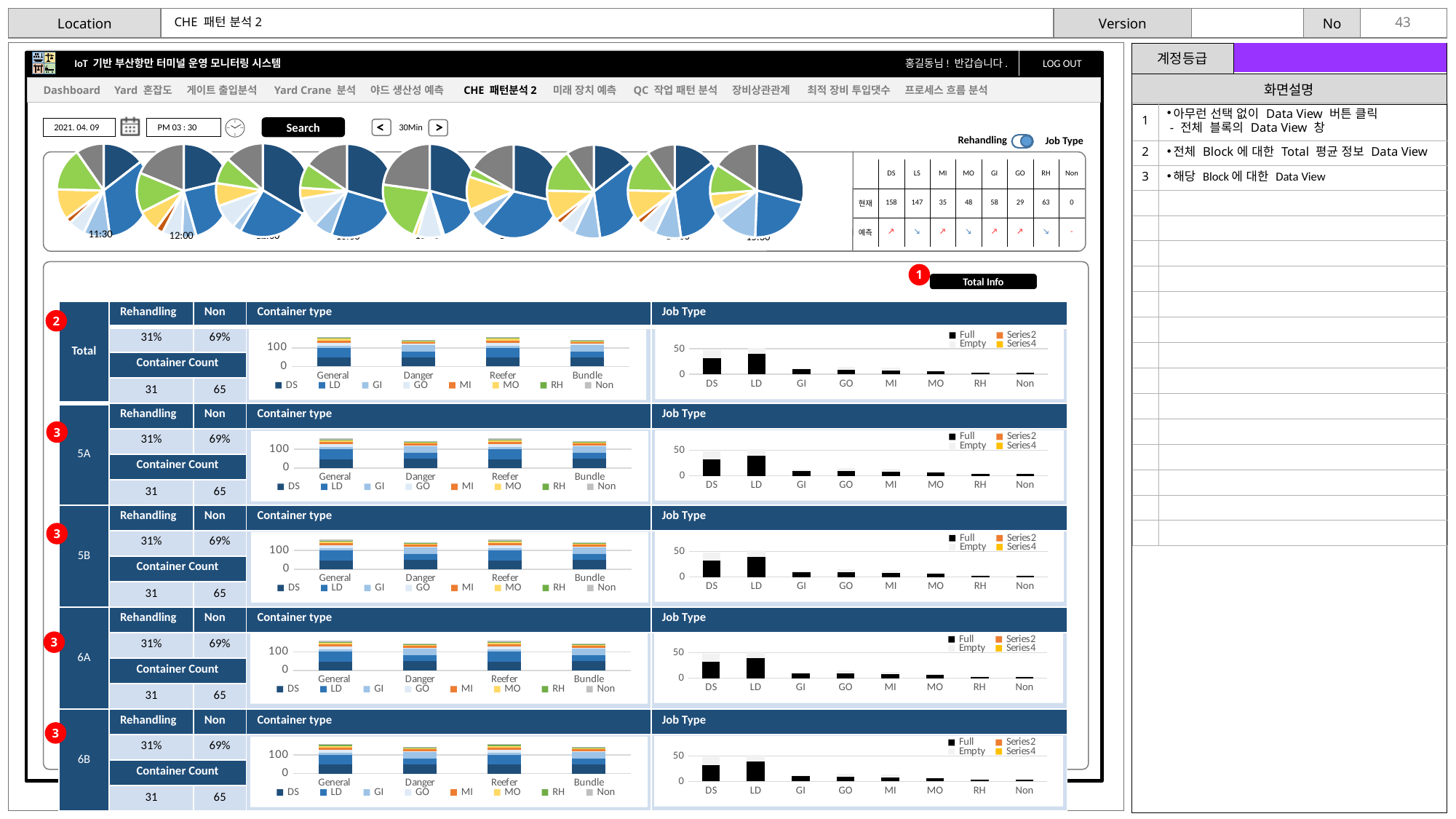
In the Total block's Job Type chart, how many entries does the legend list? 4 In the Total block's Job Type chart, what kind of chart is shown? bar chart In the 6A block's Job Type chart, which of DS or Non has the larger value? DS In the Total block's Job Type chart, what are the legend entries? Full, Empty, Series2, Series4 In the 6B block's Container type chart, what are the four categories on the x axis? General, Danger, Reefer, Bundle In the Total block's Job Type chart, how many categories are shown on the x axis? 8 In the Total block's Job Type chart, is the value for DS greater or less than 50? less In the Total block's Container type chart, how many categories are shown on the x axis? 4 In the Total block's Container type chart, how many series does the legend list? 8 How many pie charts are shown in the row at the top of the dashboard? 9 In the 5B block's Job Type chart, which of GI or LD has the larger value? LD